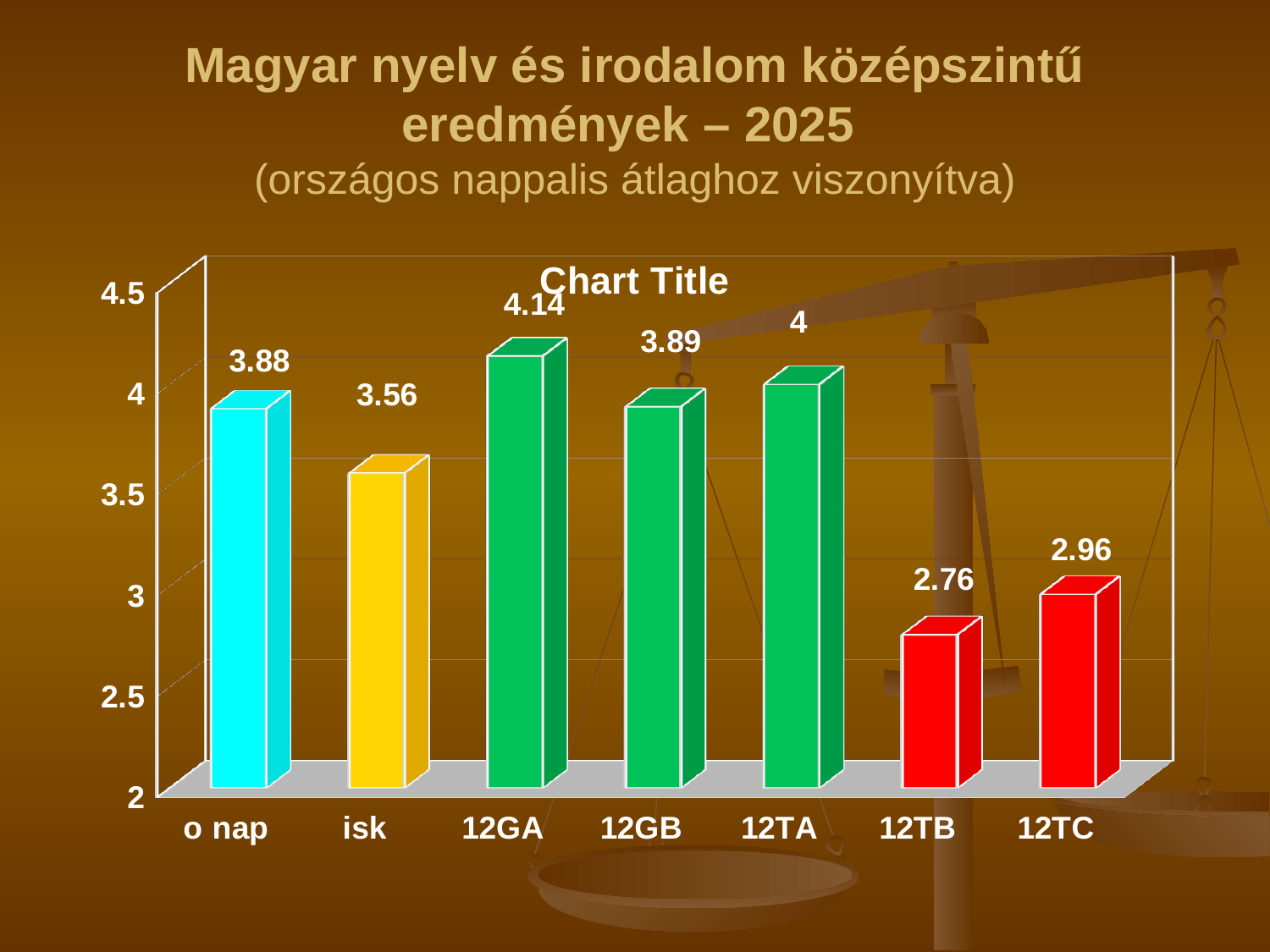
Is the value for isk greater or less than 3.5? greater What kind of chart is shown on the slide? bar chart Which category has the lowest value? 12TB What is the value for o nap? 3.88 Which category has the highest value? 12GA What is the difference between the values for 12GA and 12TB? 1.38 What is the value for 12TB? 2.76 What is the value for 12GA? 4.14 What colour are the bars for 12TB and 12TC? red Which is larger, the value for 12TA or the value for 12TC? 12TA How many categories are shown on the x axis? 7 What is the difference between the values for o nap and isk? 0.32